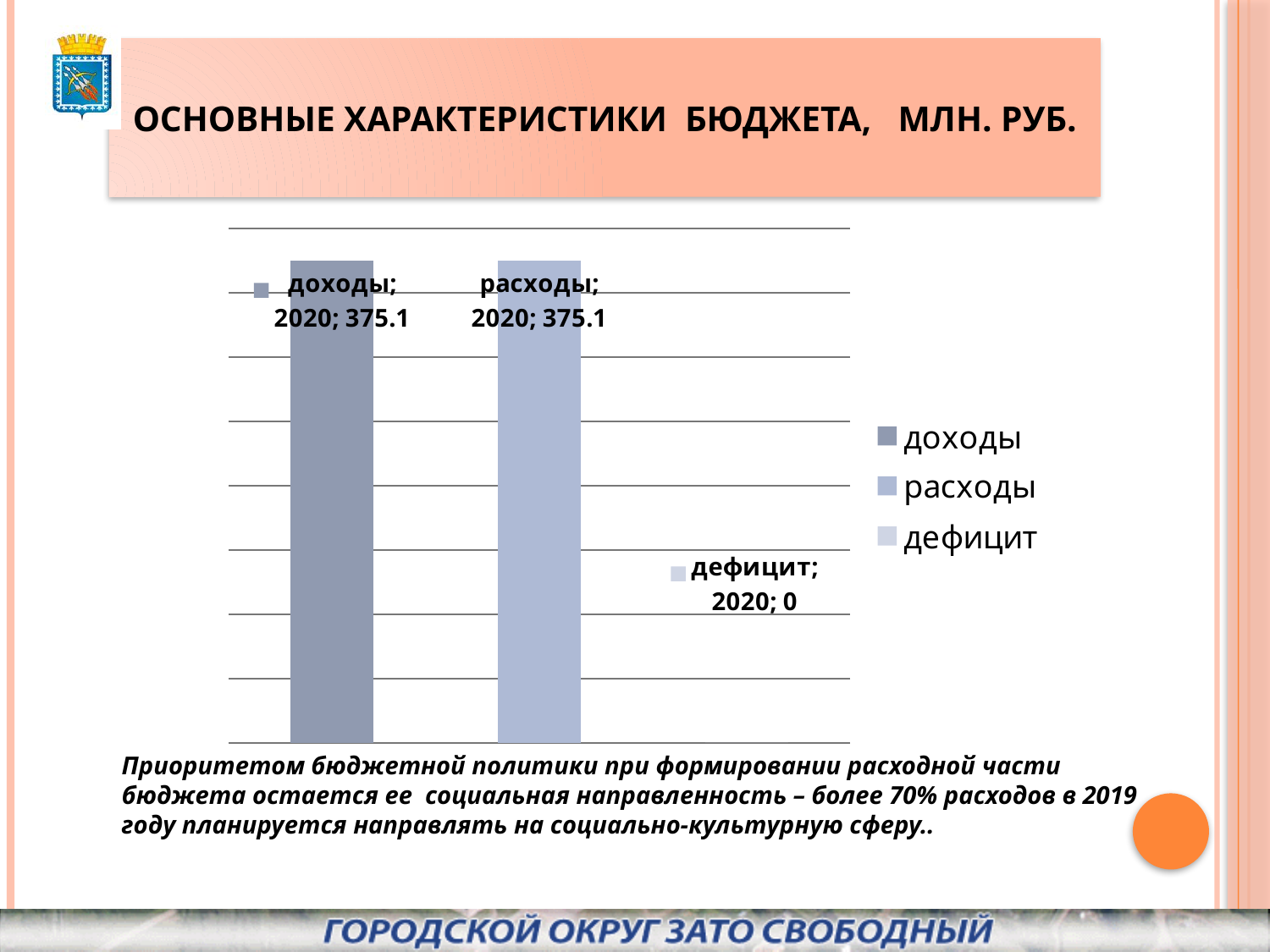
How many series does the legend list? 3 Which year do the data labels in the chart refer to? 2020 Which series has the lowest value in the chart? дефицит What kind of chart is shown on the slide? bar chart What is the difference between the values for доходы and дефицит in 2020? 375.1 What is the value for дефицит in 2020? 0 Which is larger, the value for расходы or the value for дефицит? расходы What is the difference between the values for доходы and расходы in 2020? 0 What is the value for доходы in 2020? 375.1 In what units are the budget values given, according to the slide title? млн. руб. What is the value for расходы in 2020? 375.1